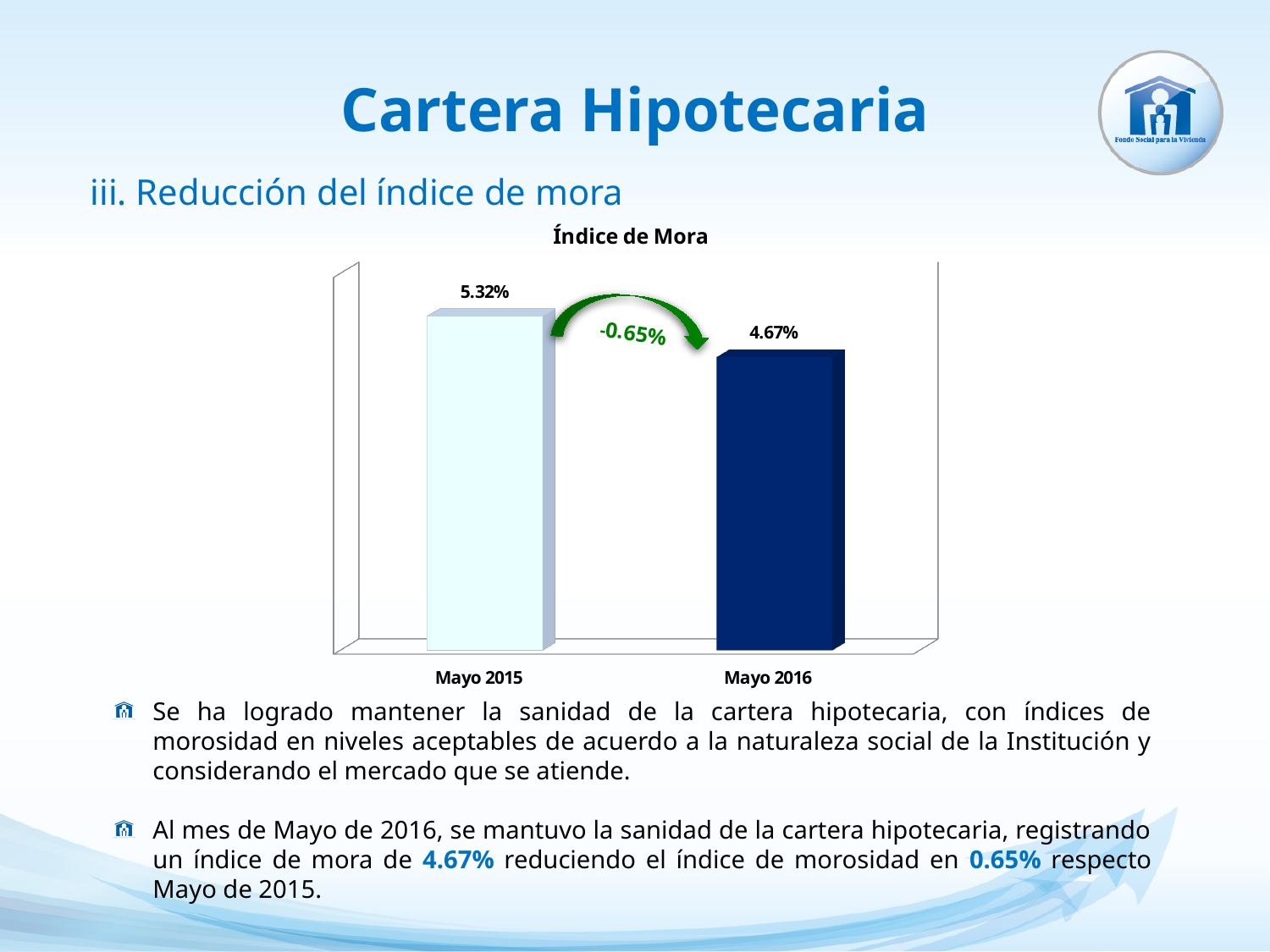
Do the values in the Índice de Mora chart rise or fall from Mayo 2015 to Mayo 2016? Fall How many categories are shown in the Índice de Mora chart? 2 Which category has the lowest value in the Índice de Mora chart? Mayo 2016 What is the title of the chart on the slide? Índice de Mora What is the difference between the Mayo 2015 and Mayo 2016 values in the Índice de Mora chart? 0.65% What change is labelled on the green arrow between the two bars in the Índice de Mora chart? -0.65% Which is larger in the Índice de Mora chart, the value for Mayo 2015 or Mayo 2016? Mayo 2015 Which category has the highest value in the Índice de Mora chart? Mayo 2015 What is the value for Mayo 2016 in the Índice de Mora chart? 4.67% What kind of chart is the Índice de Mora chart? Bar chart What is the value for Mayo 2015 in the Índice de Mora chart? 5.32%